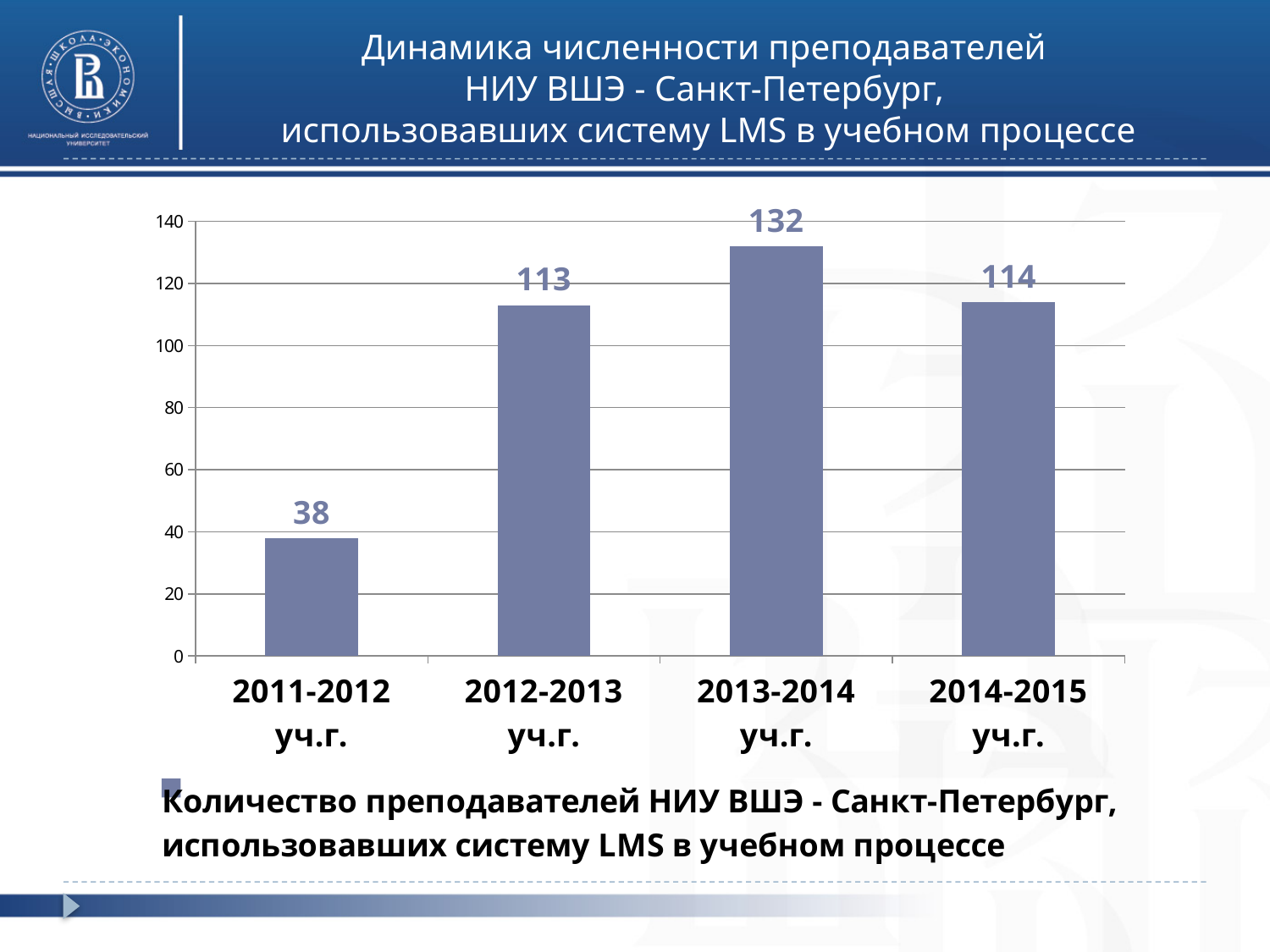
What is the value for 2014-2015 уч.г.? 114 How many academic years are shown on the chart? 4 What kind of chart is shown on the slide? bar chart Is the value for 2013-2014 уч.г. greater or less than 120? greater Does the value rise or fall from 2013-2014 уч.г. to 2014-2015 уч.г.? fall What is the difference between the values for 2012-2013 уч.г. and 2011-2012 уч.г.? 75 Which is larger, the value for 2012-2013 уч.г. or 2014-2015 уч.г.? 2014-2015 уч.г. Which academic year has the lowest value? 2011-2012 уч.г. What is the value for 2011-2012 уч.г.? 38 What is the value for 2013-2014 уч.г.? 132 What is the difference between the values for 2013-2014 уч.г. and 2012-2013 уч.г.? 19 Which academic year has the highest value? 2013-2014 уч.г.